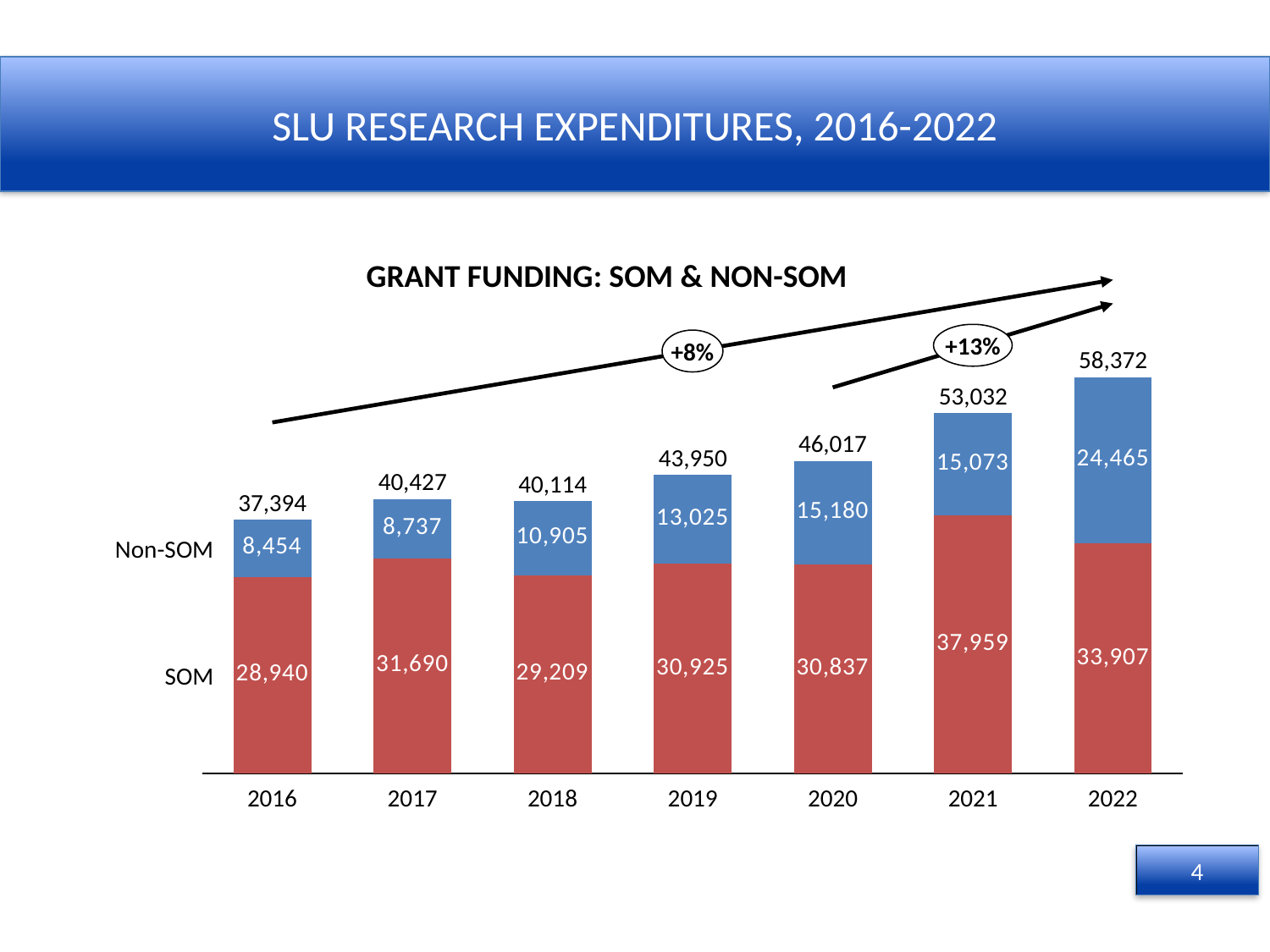
How many years are shown on the x axis? 7 What is the SOM value for 2021? 37,959 What is the Non-SOM value for 2019? 13,025 What is the title of the chart? GRANT FUNDING: SOM & NON-SOM Which year has the highest total grant funding? 2022 Which is larger, the SOM value for 2017 or the SOM value for 2018? 2017 What is the difference between the Non-SOM values for 2022 and 2021? 9,392 What is the total grant funding shown for 2022? 58,372 How many series does the chart show? 2 Which year has the lowest Non-SOM value? 2016 Do the total grant funding values generally rise or fall from 2016 to 2022? Rise What kind of chart is this? Stacked bar chart